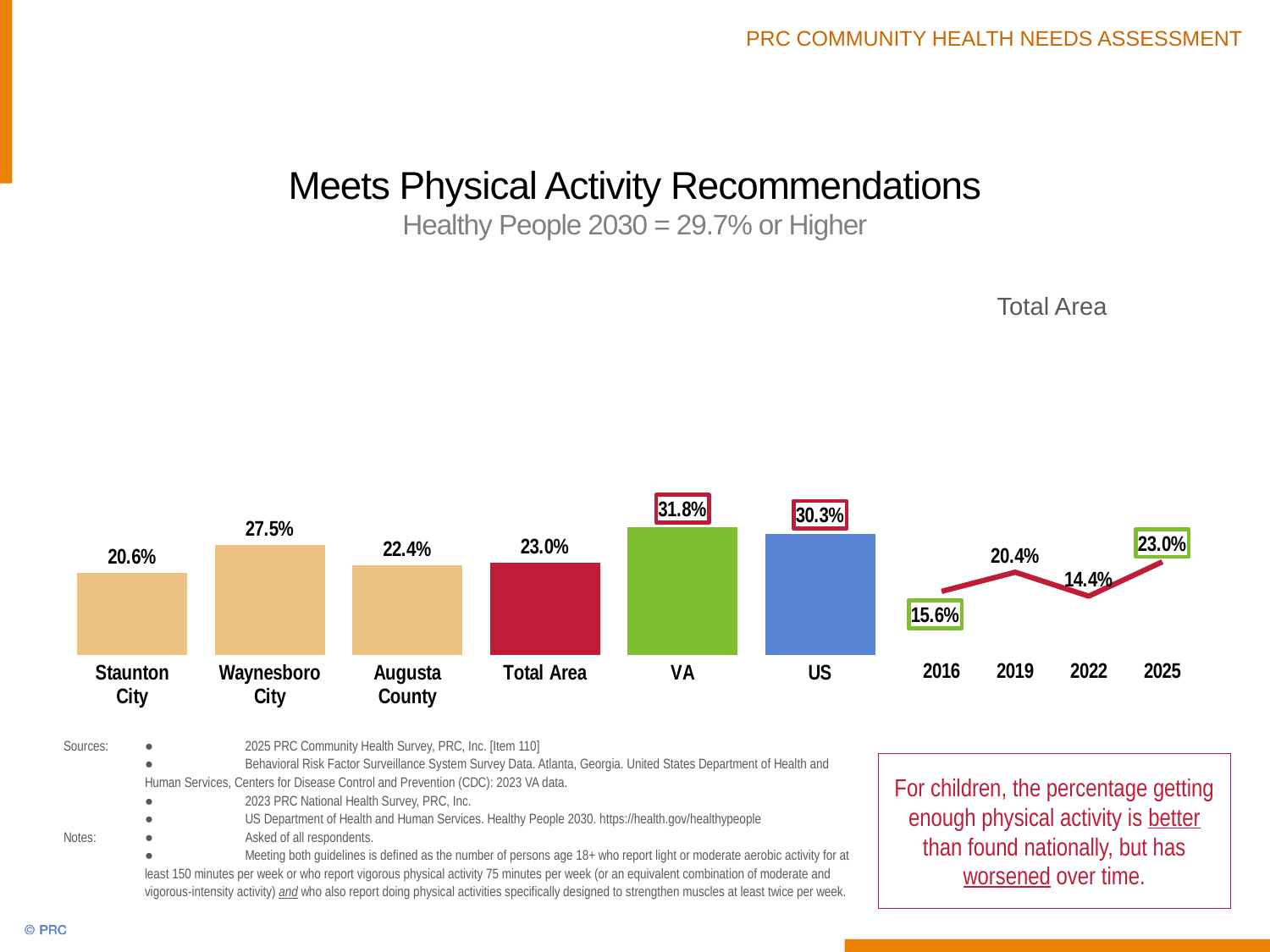
In the Total Area trend chart on the right, which year has the lowest value? 2022 In the bar chart, what is the difference between the VA value and the US value? 1.5% In the Total Area trend chart on the right, what is the difference between the 2025 value and the 2016 value? 7.4% What kind of chart is the Total Area chart on the right of the slide? Line chart In the bar chart, which is larger, the value for Waynesboro City or the value for Total Area? Waynesboro City How many categories are shown in the bar chart? 6 In the bar chart, what is the value for Augusta County? 22.4% In the bar chart, what is the value for Waynesboro City? 27.5% In the bar chart, which category has the lowest value? Staunton City What kind of chart is the chart on the left of the slide? Bar chart In the Total Area trend chart on the right, what is the value for 2022? 14.4% In the bar chart, which category has the highest value? VA